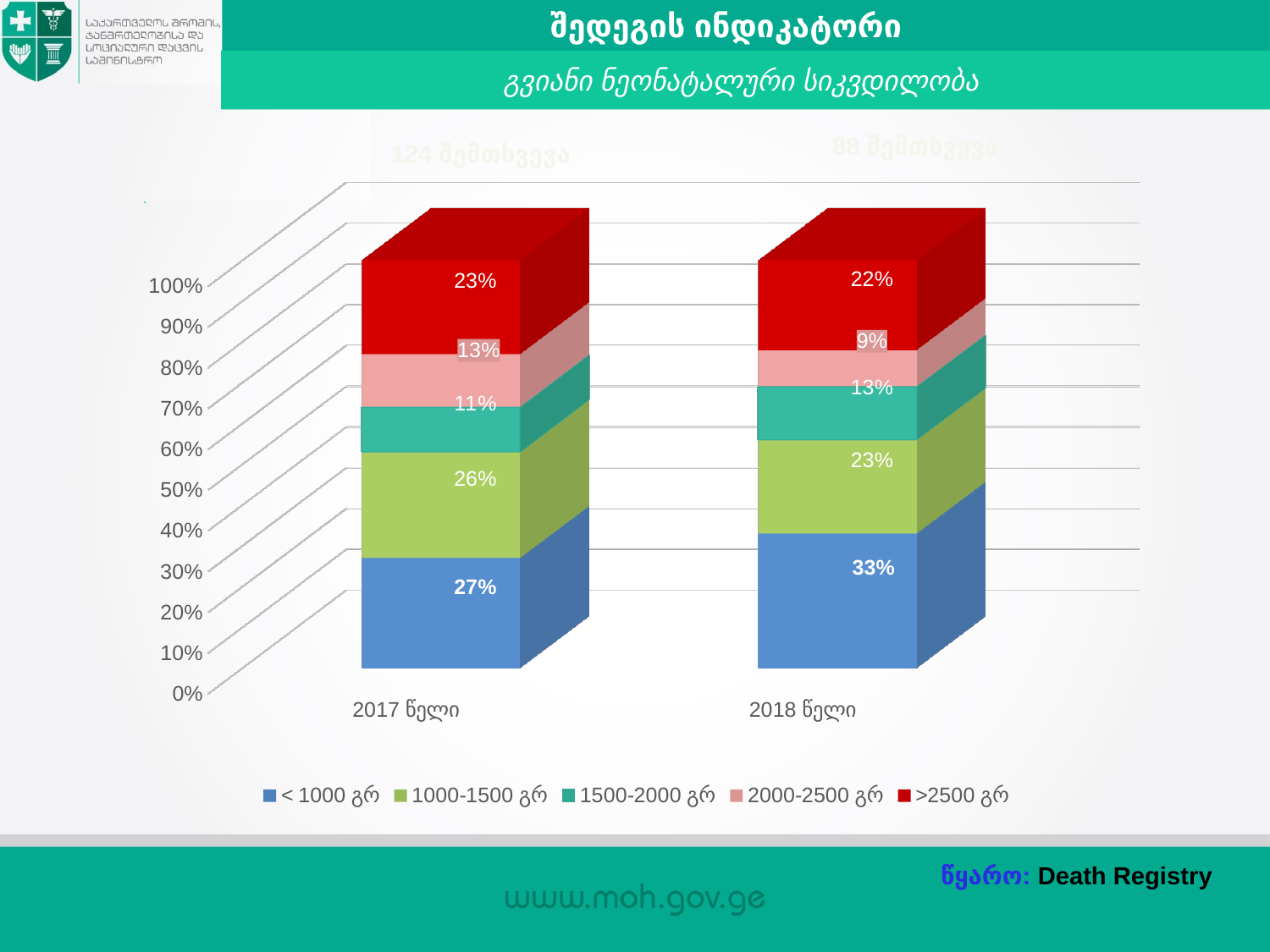
What percentage does the < 1000 გრ segment show for 2018 წელი? 33% Which weight group has the smallest share in the 2018 წელი bar? 2000-2500 გრ How many years are shown on the x axis? 2 What kind of chart is shown on the slide? Stacked bar chart By how many percentage points does the < 1000 გრ share in 2018 წელი exceed that in 2017 წელი? 6 How many series does the legend list? 5 What is the value of the 1000-1500 გრ segment for 2017 წელი? 26% What is the value of the >2500 გრ segment for 2017 წელი? 23% Which weight group has the largest share in the 2018 წელი bar? < 1000 გრ Is the 1500-2000 გრ share larger in 2017 წელი or 2018 წელი? 2018 წელი What is the value of the 2000-2500 გრ segment for 2018 წელი? 9% What percentage does the < 1000 გრ segment show for 2017 წელი? 27%